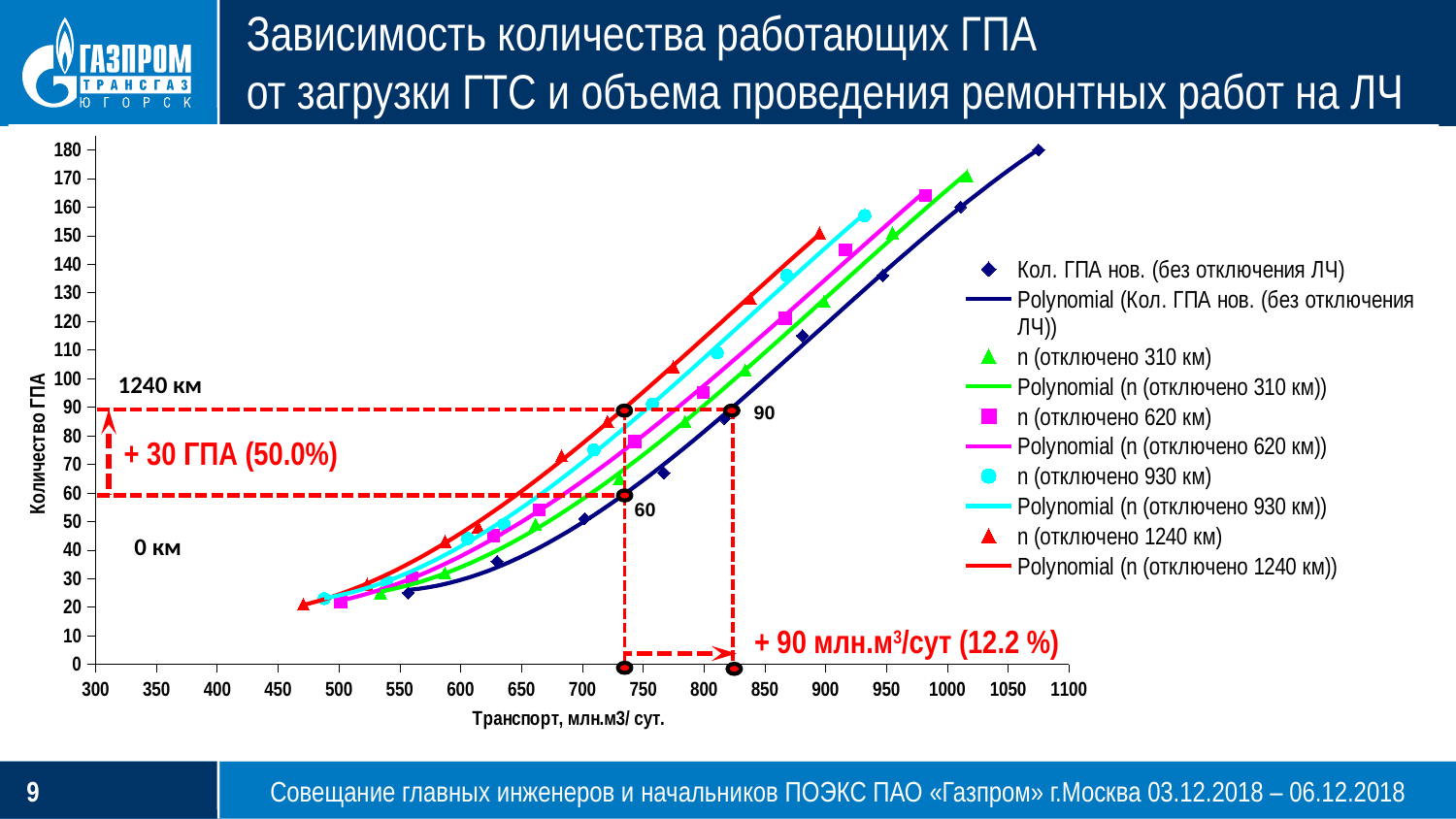
Do the values of the series rise or fall as transport increases along the x axis? rise What kind of chart is shown on the slide? scatter chart with trend lines Is the highest value of the series 'n (отключено 1240 км)' greater or less than 140? greater How many entries does the chart legend list? 10 How many scatter (point) series are plotted on the chart, excluding the polynomial trend lines? 5 What increase in transport is annotated in red on the chart? + 90 млн.м3/сут (12.2 %) What increase in the number of ГПА is annotated in red on the chart? + 30 ГПА (50.0%) At a transport of about 800 млн.м3/сут, which is higher: the red line (отключено 1240 км) or the dark blue line (без отключения ЛЧ)? the red line (отключено 1240 км) What is the title of the vertical axis? Количество ГПА Which series reaches the highest number of ГПА on the chart? Кол. ГПА нов. (без отключения ЛЧ) What is the maximum value shown on the vertical axis? 180 What is the title of the horizontal axis? Транспорт, млн.м3/ сут.